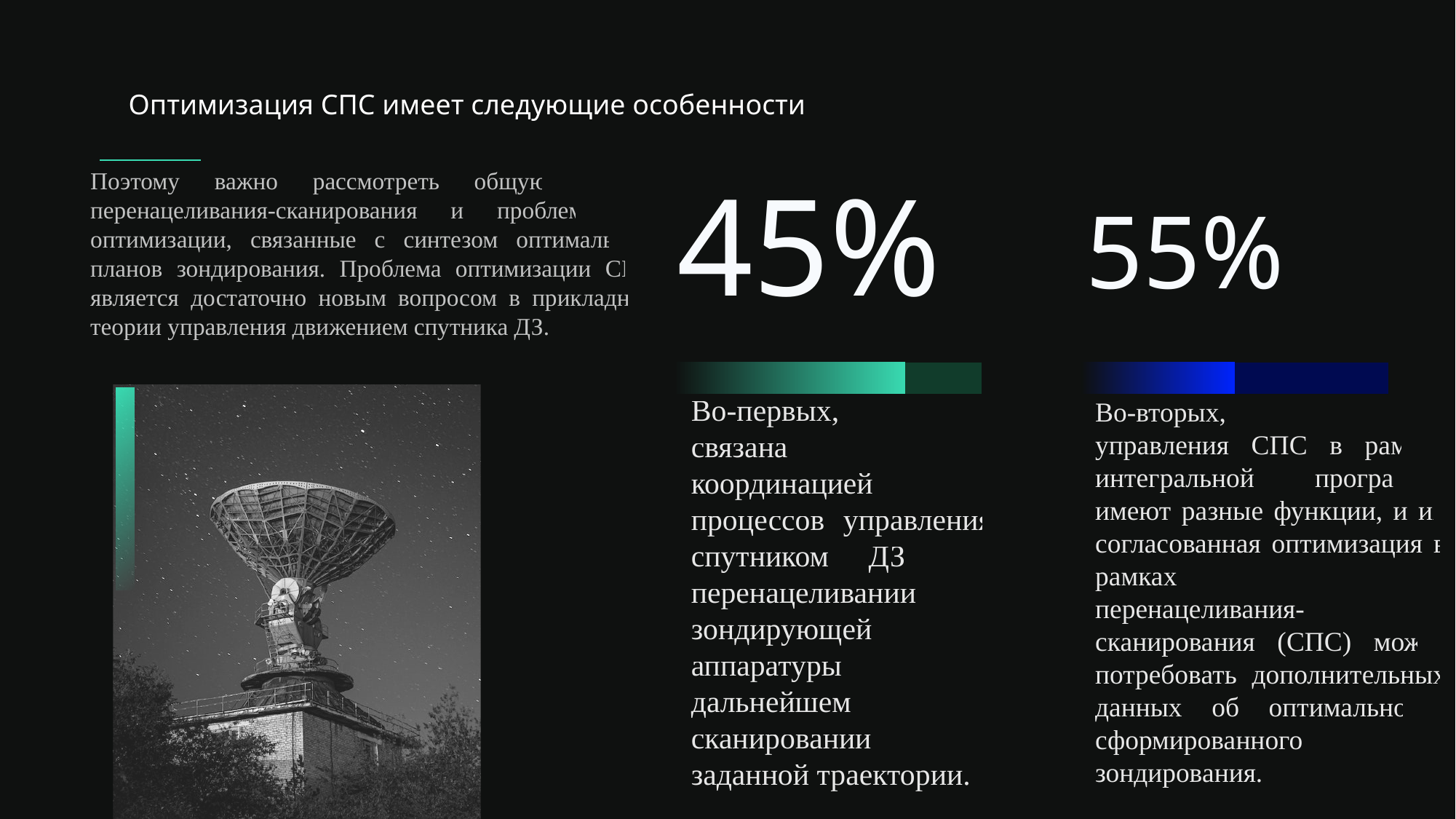
What percentage is shown above the blue bar labelled "Во-вторых"? 55% Is the value shown for "Во-первых" greater or less than 50%? less What do the two percentages shown on the slide, 45% and 55%, add up to? 100% What colour is the bar under the 55% figure? Blue Which of the two percentage indicators on the slide shows the smaller value? Во-первых What percentage is shown above the green bar labelled "Во-первых"? 45% Is the value shown for "Во-вторых" greater or less than 50%? greater How many percentage indicators are shown on the slide? 2 What colour is the bar under the 45% figure? Green What is the difference between the two percentages shown on the slide, 55% and 45%? 10% Which of the two percentage indicators on the slide shows the larger value, "Во-первых" or "Во-вторых"? Во-вторых